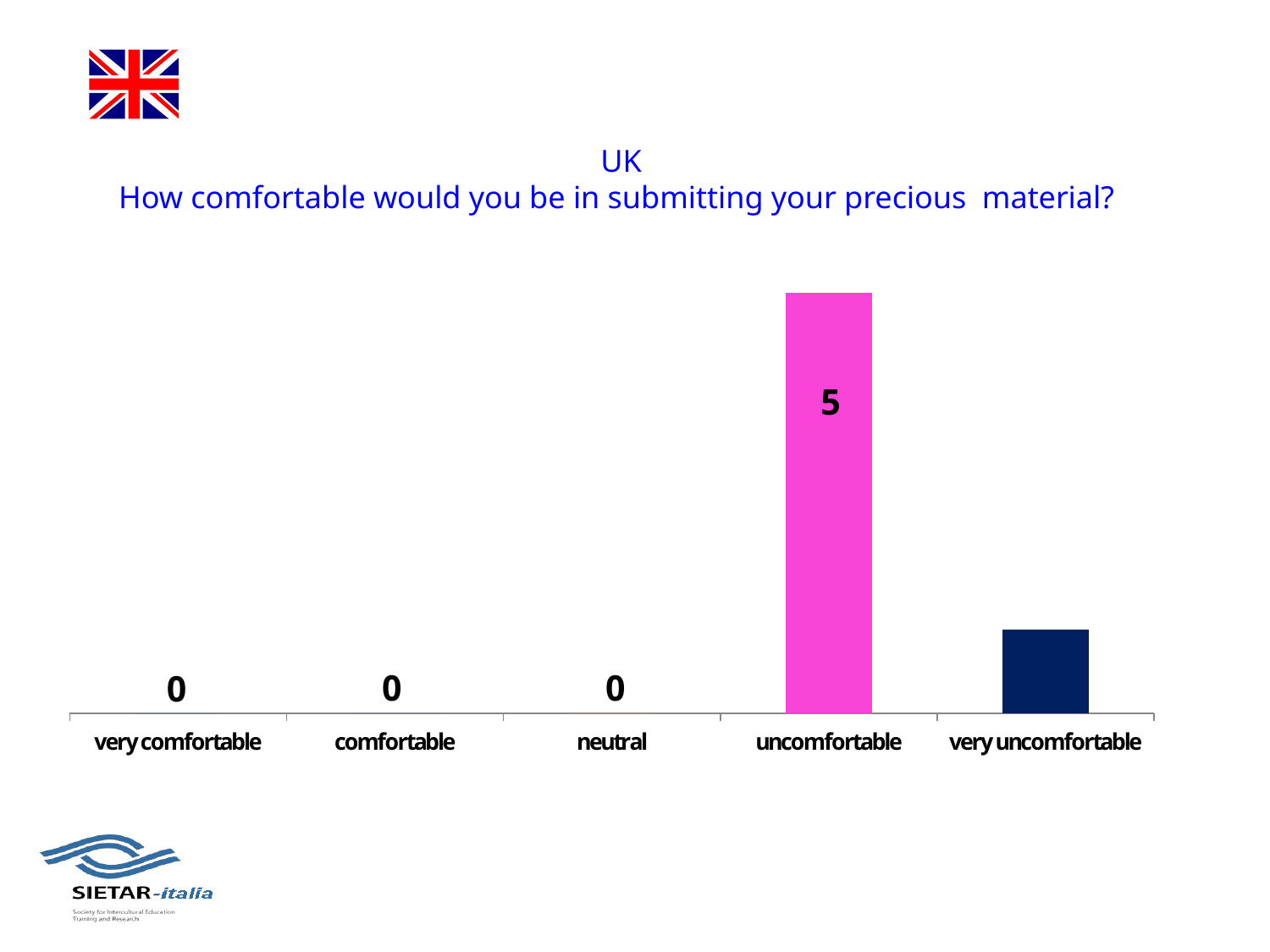
How many categories have a value of 0? 3 Which is larger, the value for 'uncomfortable' or the value for 'very uncomfortable'? uncomfortable What is the value for 'very comfortable'? 0 What colour is the bar for 'uncomfortable'? pink Which category has the highest value? uncomfortable How many categories are shown on the x axis? 5 What is the value for 'uncomfortable'? 5 What is the difference between the value for 'uncomfortable' and the value for 'neutral'? 5 What is the value for 'comfortable'? 0 What kind of chart is shown on the slide? bar chart What is the value for 'neutral'? 0 Which country does the chart title refer to? UK